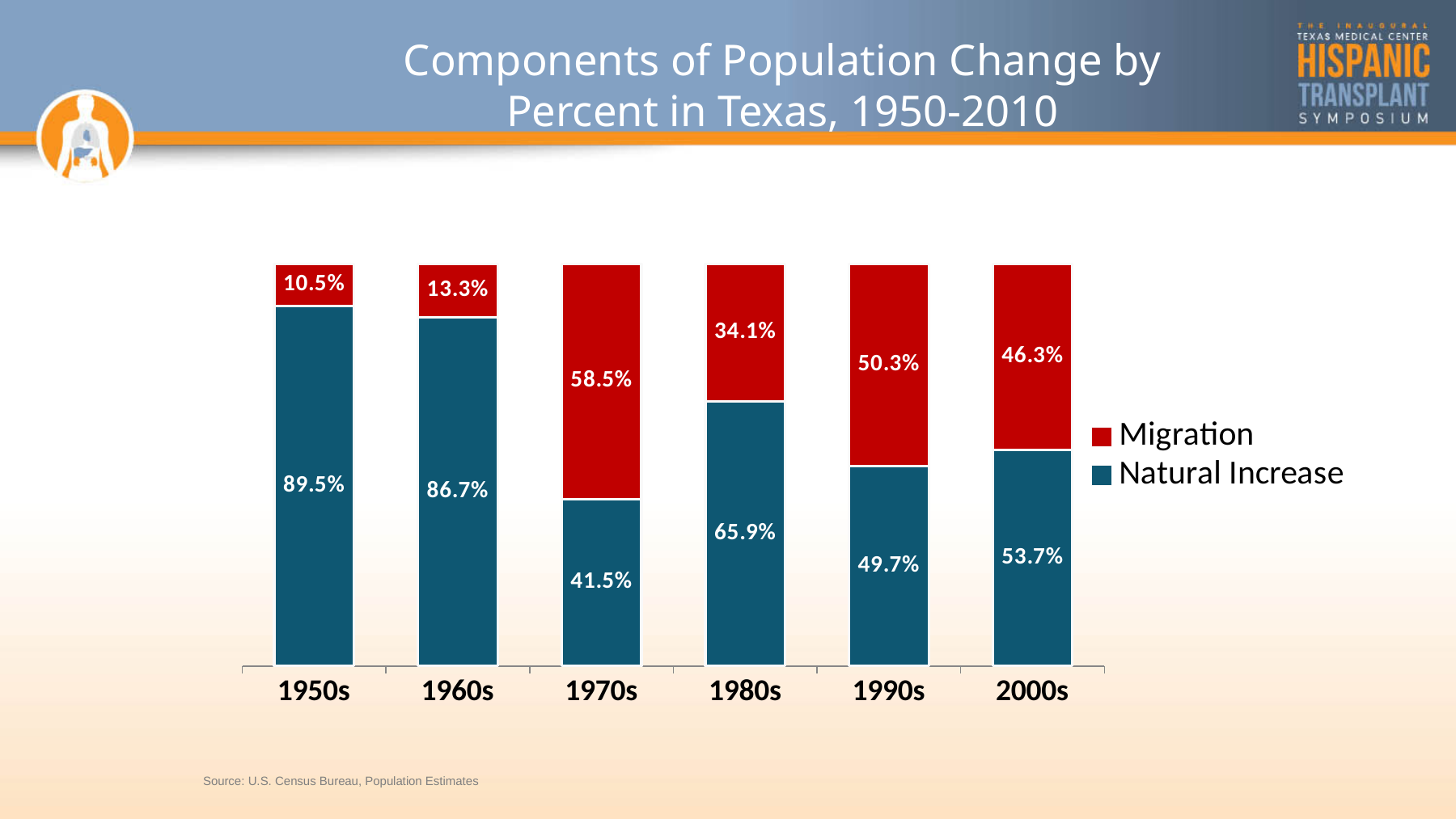
Which colour represents Migration in the legend? Red What is the Migration value for the 2000s? 46.3% Which decade has the highest Natural Increase value? 1950s What is the Natural Increase value for the 1990s? 49.7% How many series does the legend list? 2 Which is larger, the Migration value for the 1980s or the Migration value for the 1990s? 1990s What is the Migration value for the 1970s? 58.5% What kind of chart is shown on the slide? Stacked bar chart What is the difference between the Natural Increase values for the 1960s and the 1980s? 20.8% What is the total of the stacked bar for the 1970s? 100% Which decade has the lowest Migration value? 1950s How many decades are shown on the x axis? 6